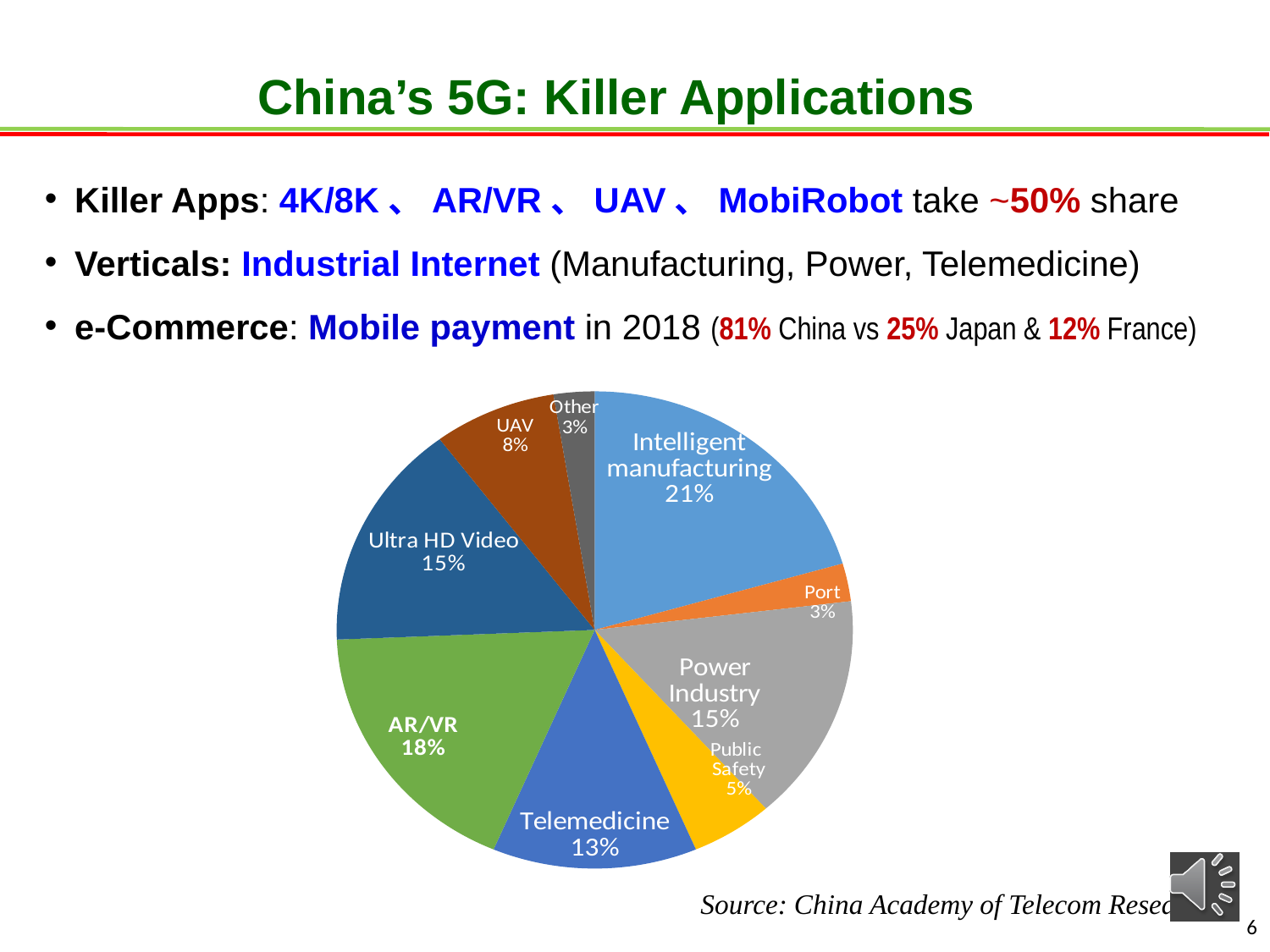
How many slices does the pie chart have? 9 What is the value shown for Public Safety? 5% What kind of chart is shown on the slide? Pie chart Which is larger, the share for Ultra HD Video or the share for Telemedicine? Ultra HD Video Which slice of the pie is the largest? Intelligent manufacturing What is the difference between the shares of Power Industry and Port? 12% What is the value shown for UAV? 8% What is the value shown for Telemedicine? 13% What share of the pie does AR/VR have? 18% What share of the pie does Intelligent manufacturing have? 21% Which two slices both have a share of 15%? Ultra HD Video and Power Industry What is the difference between the shares of Intelligent manufacturing and AR/VR? 3%